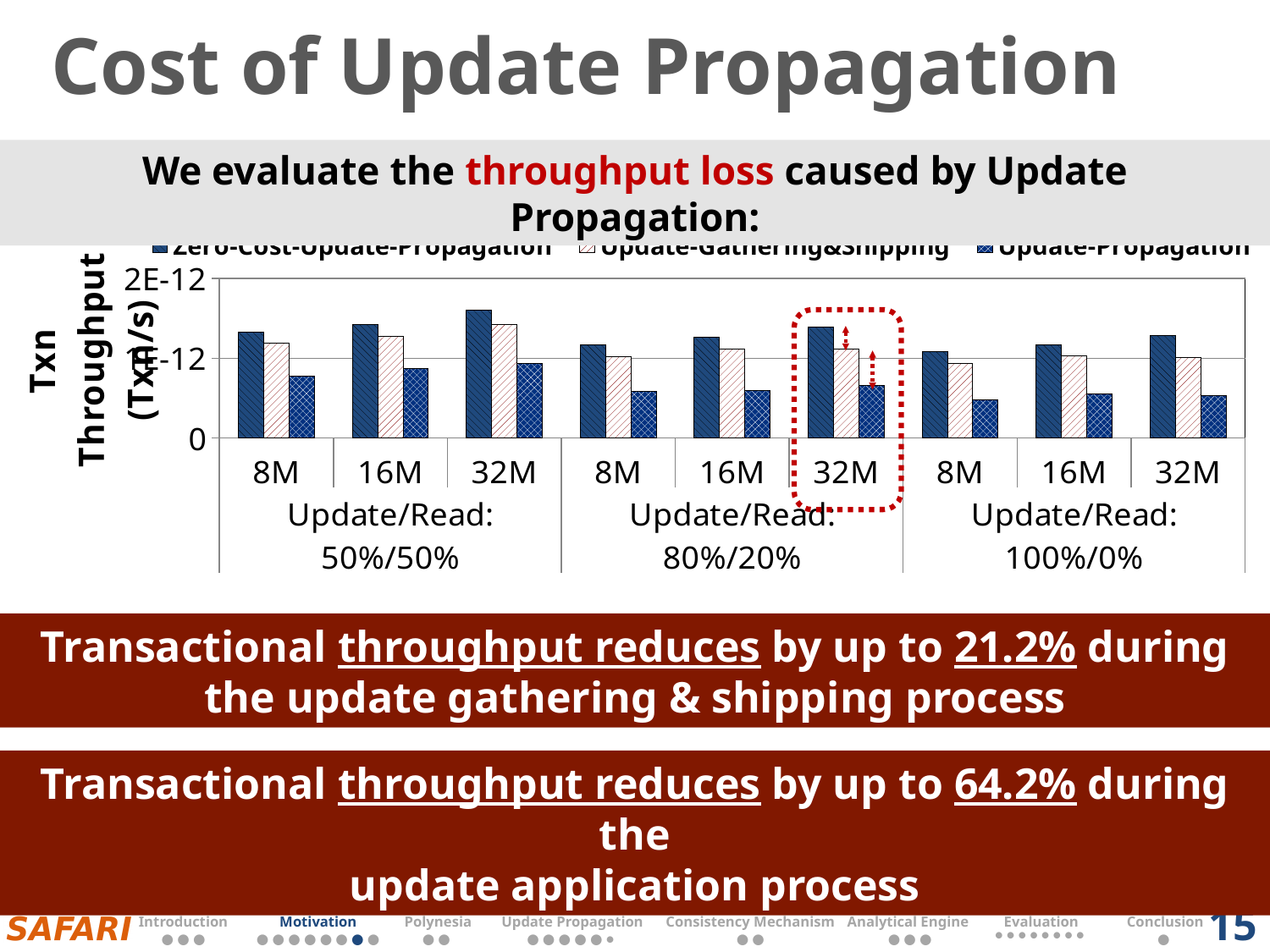
Within the Update/Read: 50%/50% group, do the Zero-Cost-Update-Propagation values rise or fall from 8M to 32M? rise How many category groups (bars clusters) are plotted along the x axis of the chart? 9 For 32M under Update/Read: 80%/20%, which is larger: the Zero-Cost-Update-Propagation value or the Update-Propagation value? Zero-Cost-Update-Propagation Which series is shown with the solid dark blue bars in the chart? Zero-Cost-Update-Propagation Is the Update-Gathering&Shipping value for 16M under Update/Read: 50%/50% greater or less than 1E-12? greater What kind of chart is shown on the slide? bar chart How many series does the chart legend list? 3 Is the Update-Propagation value for 8M under Update/Read: 80%/20% greater or less than 1E-12? less Is the Update-Propagation value for 32M under Update/Read: 100%/0% greater or less than 1E-12? less Across all groups, for which category does the Zero-Cost-Update-Propagation series reach its highest value? 32M under Update/Read: 50%/50% What is the label of the y axis of the chart? Txn Throughput (Txn/s)